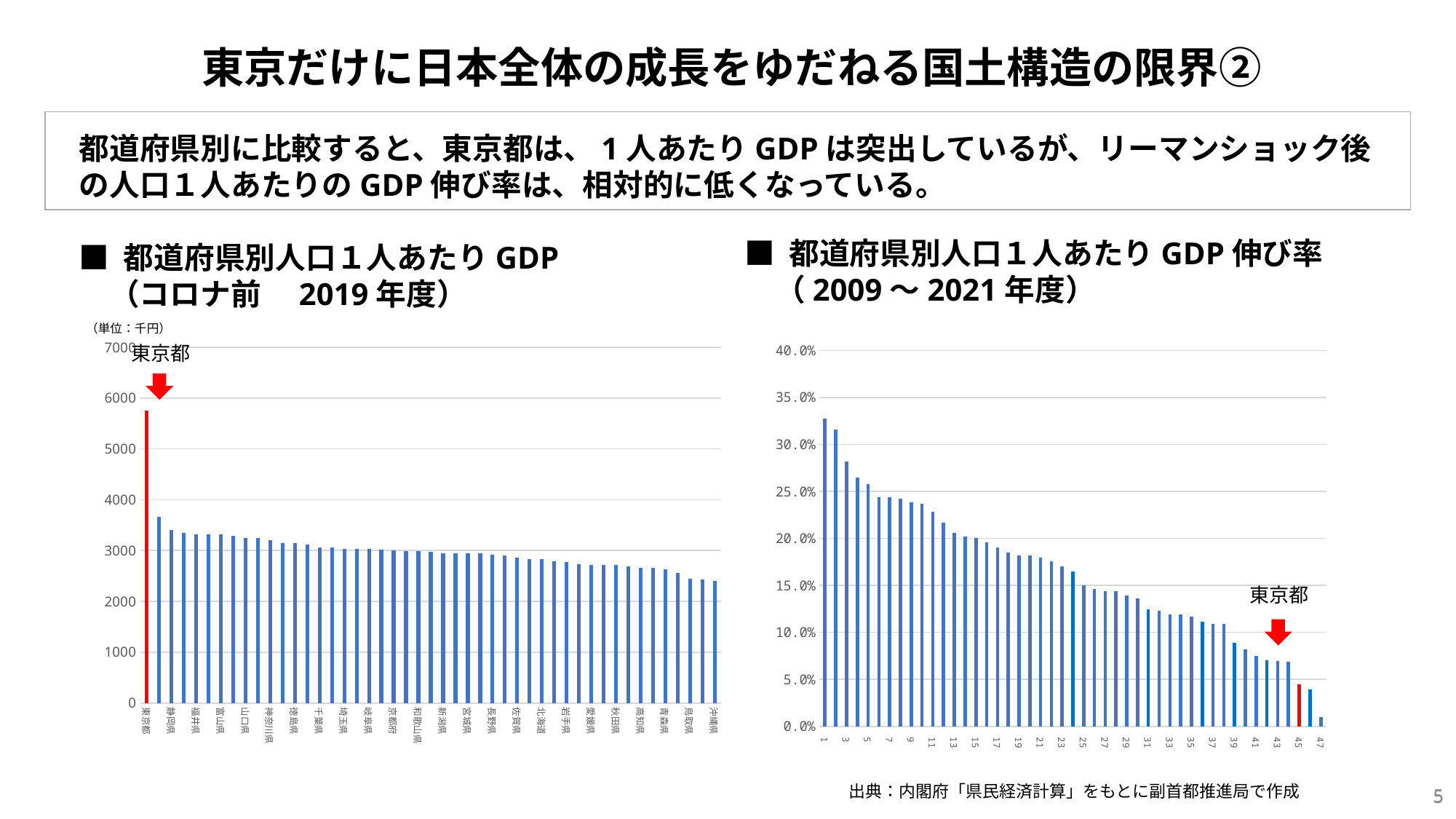
What kind of chart is the right chart (都道府県別人口1人あたりGDP伸び率)? bar chart In the left chart (都道府県別人口1人あたりGDP), what unit is shown for the values? 千円 In the right chart (都道府県別人口1人あたりGDP伸び率), is the value for bar 1 greater or less than 30.0%? greater In the left chart (都道府県別人口1人あたりGDP), is the value for 沖縄県 greater or less than 3000? less In the right chart (都道府県別人口1人あたりGDP伸び率), is the value for 東京都 (the red bar) greater or less than 10.0%? less In the left chart (都道府県別人口1人あたりGDP), which prefecture has the highest value? 東京都 In the right chart (都道府県別人口1人あたりGDP伸び率), do the values rise or fall from left to right along the x axis? fall What kind of chart is the left chart (都道府県別人口1人あたりGDP)? bar chart In the left chart (都道府県別人口1人あたりGDP), do the values rise or fall from left to right along the x axis? fall In the right chart (都道府県別人口1人あたりGDP伸び率), how many bars are plotted? 47